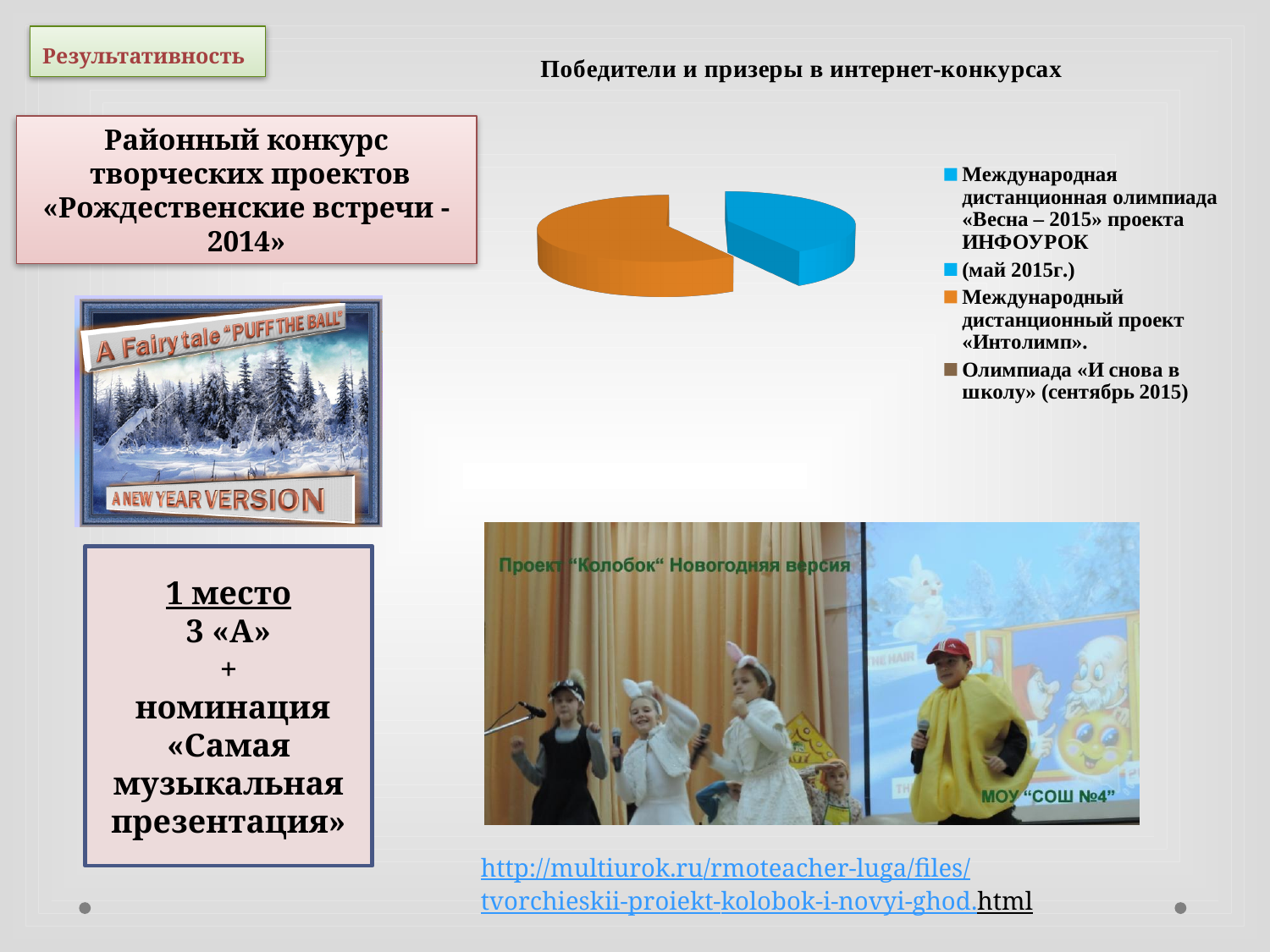
How many slices are visible in the pie chart? 2 What colour is the slice for Международная дистанционная олимпиада «Весна – 2015» проекта ИНФОУРОК? blue What is the title of the chart on the slide? Победители и призеры в интернет-конкурсах Which legend entry corresponds to the largest slice of the pie chart? Международный дистанционный проект «Интолимп». Does the blue slice of the pie chart take up more or less than half of the pie? less What kind of chart is shown on the slide? pie chart Which slice is larger: the orange slice (Международный дистанционный проект «Интолимп») or the blue slice (Международная дистанционная олимпиада «Весна – 2015» проекта ИНФОУРОК)? the orange slice (Международный дистанционный проект «Интолимп») How many entries does the chart's legend list? 4